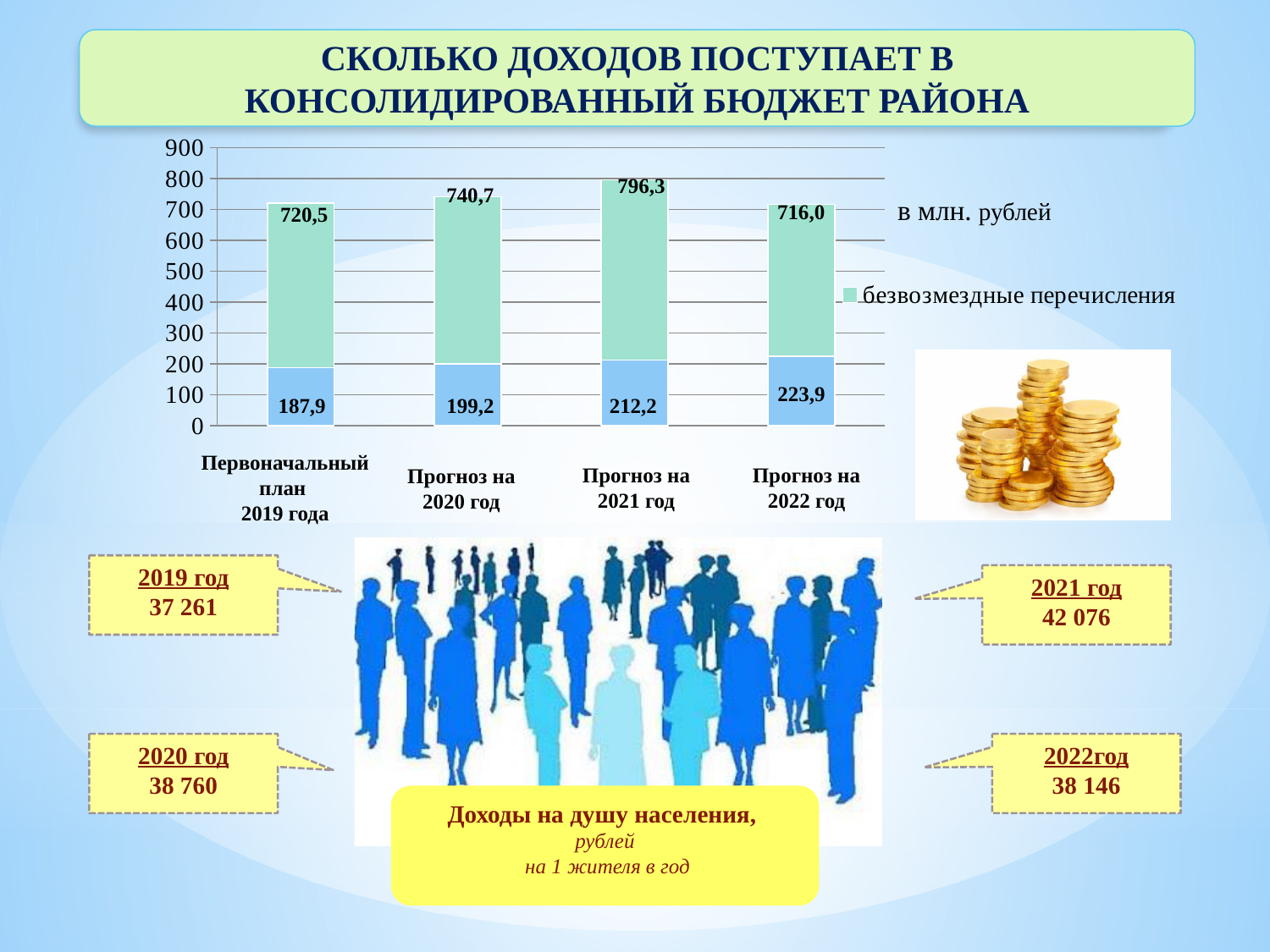
How many categories (bars) does the chart show? 4 Do the blue (bottom) segment values rise or fall from 2019 to 2022 along the x axis? rise What value is printed at the top of the bar for 'Прогноз на 2021 год'? 796,3 Which category has the tallest bar? Прогноз на 2021 год What value is printed at the top of the bar for 'Прогноз на 2020 год'? 740,7 Which category has the smallest blue (bottom) segment? Первоначальный план 2019 года How many series does the chart legend list? 1 What is the value of the blue (bottom) segment for 'Первоначальный план 2019 года'? 187,9 What is the value of the blue (bottom) segment for 'Прогноз на 2022 год'? 223,9 What is the legend entry shown for the green series? безвозмездные перечисления What kind of chart is shown on the slide? bar chart What is the difference between the blue segment values for 'Прогноз на 2022 год' and 'Первоначальный план 2019 года'? 36,0